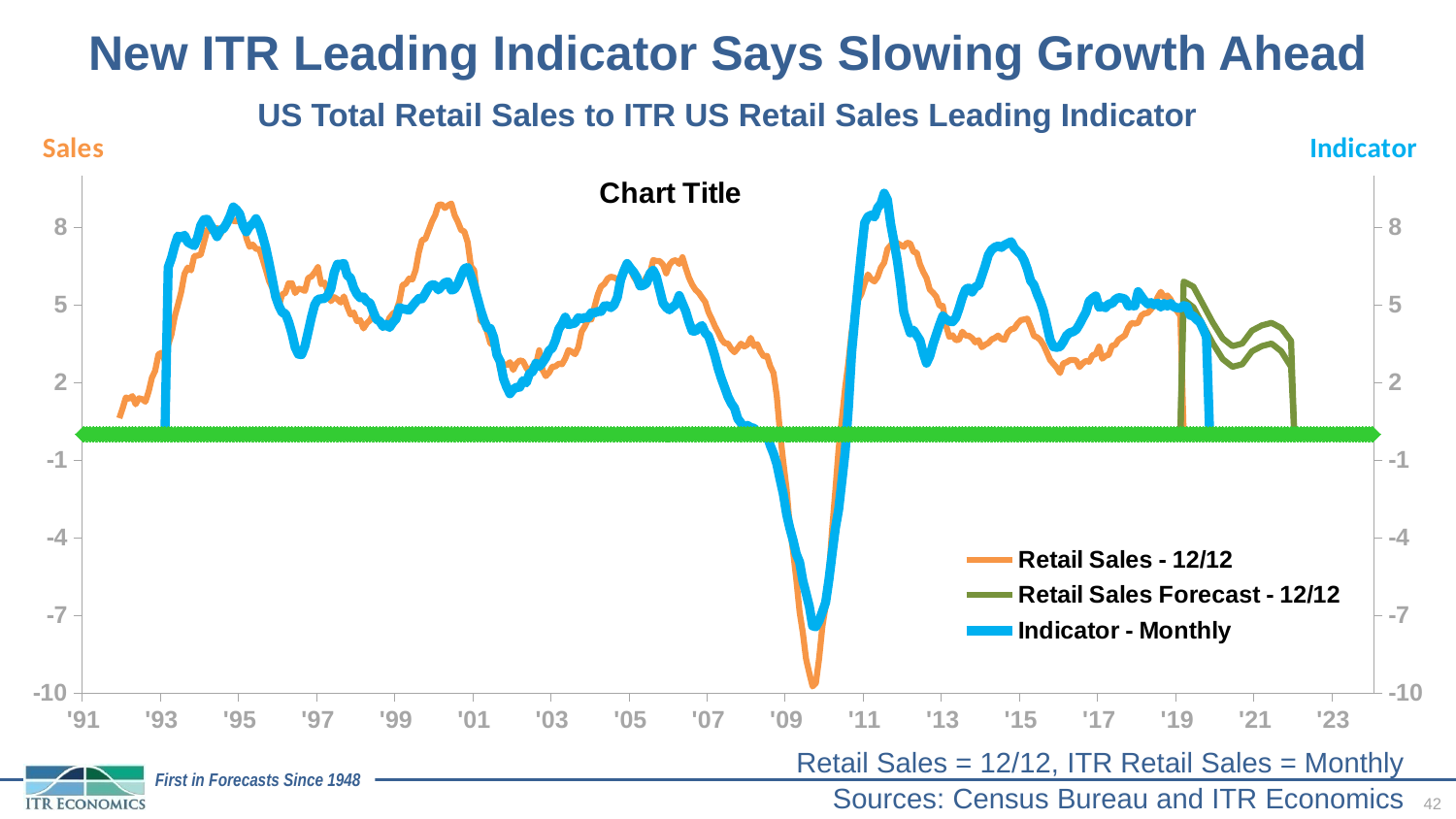
Is the peak of the Indicator - Monthly line around 2011 greater or less than 8? greater Is the Retail Sales Forecast - 12/12 value at its start around 2019 greater or less than 5? greater How many year labels are shown along the x axis? 17 Is the peak of the Retail Sales - 12/12 line around 2000 greater or less than 8? greater What label appears above the left-hand axis? Sales What kind of chart is shown on the slide? line chart Around 2009, which line drops lower: Retail Sales - 12/12 or Indicator - Monthly? Retail Sales - 12/12 Which series is drawn in blue? Indicator - Monthly Does the Retail Sales Forecast - 12/12 line rise or fall overall from 2019 to its end around 2022? fall How many series does the legend list? 3